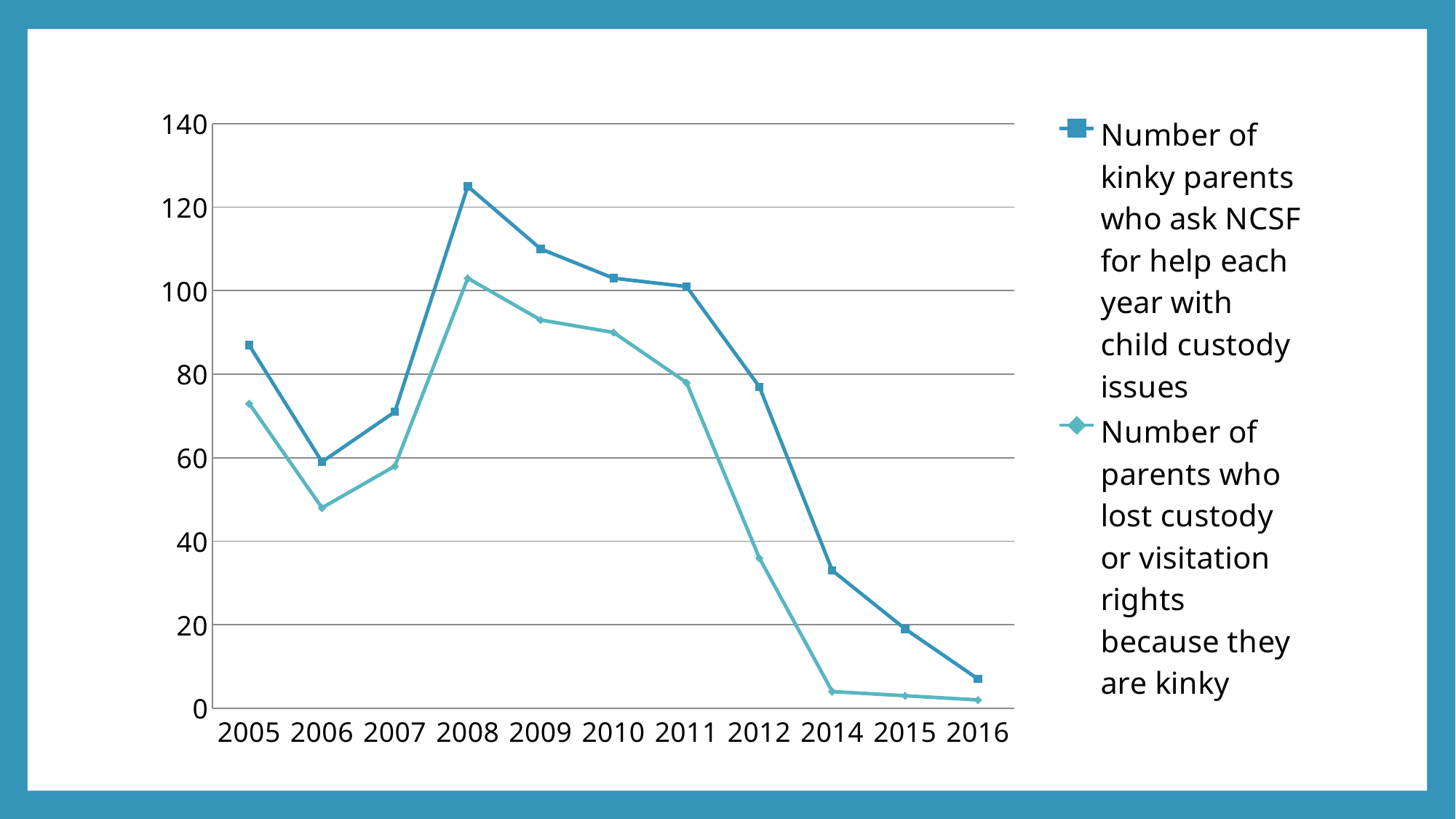
In which year is the number of kinky parents who ask NCSF for help with child custody issues highest? 2008 Is the 2014 value for the number of parents who lost custody or visitation rights because they are kinky greater or less than 20? less From 2011 to 2016, does the number of parents who lost custody or visitation rights because they are kinky rise or fall? fall How many series does the legend list? 2 What kind of chart is shown on the slide? line chart In which year is the number of kinky parents who ask NCSF for help with child custody issues lowest? 2016 In 2012, which series has the higher value: parents who ask NCSF for help or parents who lost custody or visitation rights? Number of kinky parents who ask NCSF for help each year with child custody issues Is the 2008 value for the number of kinky parents who ask NCSF for help greater or less than 100? greater What is the first year shown on the x axis? 2005 How many years are shown on the x axis? 11 Is the 2006 value for the number of parents who lost custody or visitation rights because they are kinky greater or less than 60? less In which year is the number of parents who lost custody or visitation rights because they are kinky highest? 2008